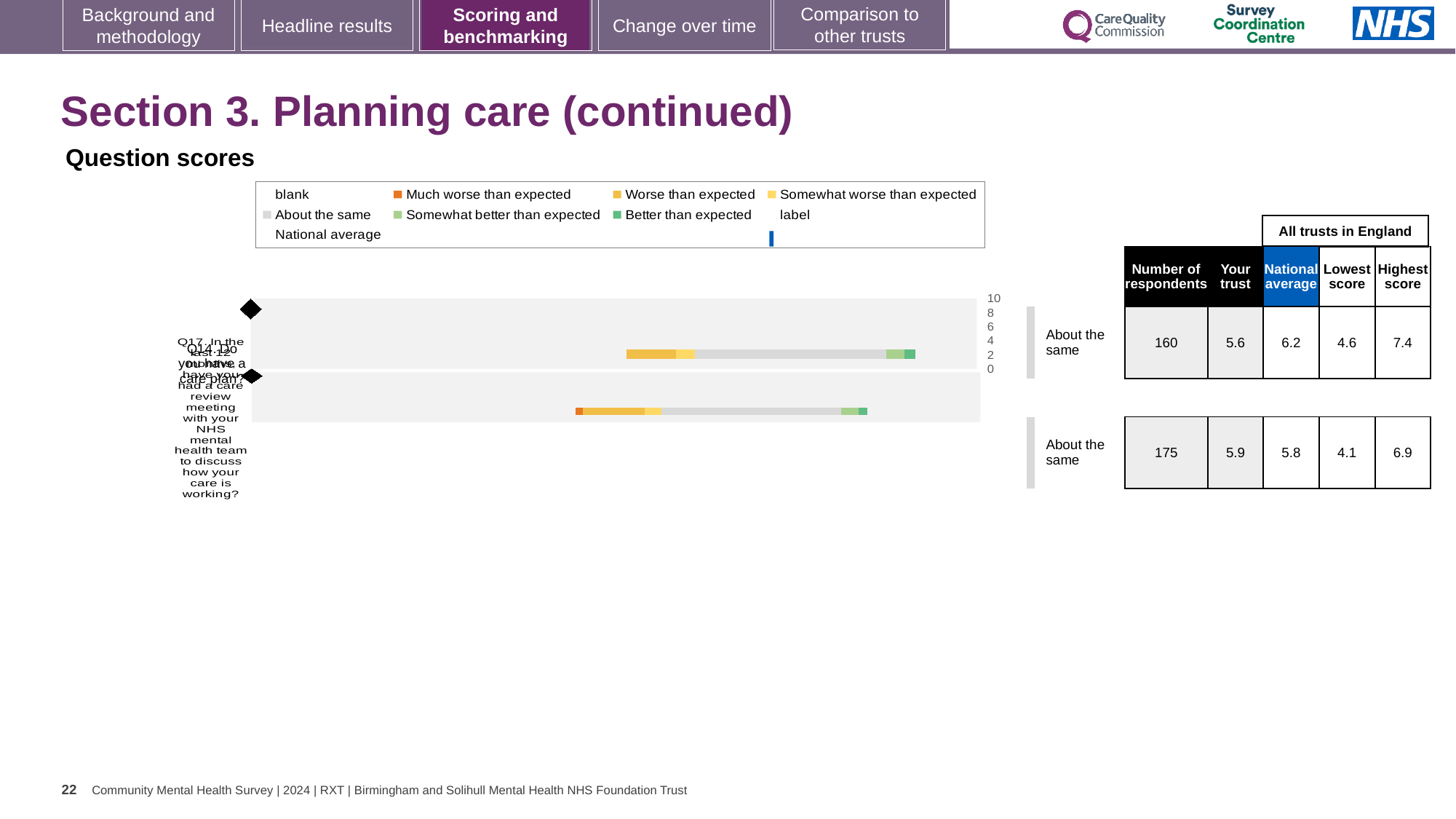
For Q14, which is larger: the trust's score or the national average? National average What is the difference between the highest and lowest scores for Q17 across all trusts in England? 2.8 What benchmark category is shown for Q14? About the same What is the highest score among all trusts in England for Q14? 7.4 Which question has the higher 'Your trust' score, Q14 or Q17? Q17 How many questions are plotted in the Question scores chart? 2 What is the lowest score among all trusts in England for Q17? 4.1 How many respondents answered Q17? 175 How many more respondents answered Q17 than Q14? 15 What kind of chart is shown under 'Question scores'? bar chart What is the national average score for Q17? 5.8 What is the 'Your trust' score for Q14? 5.6